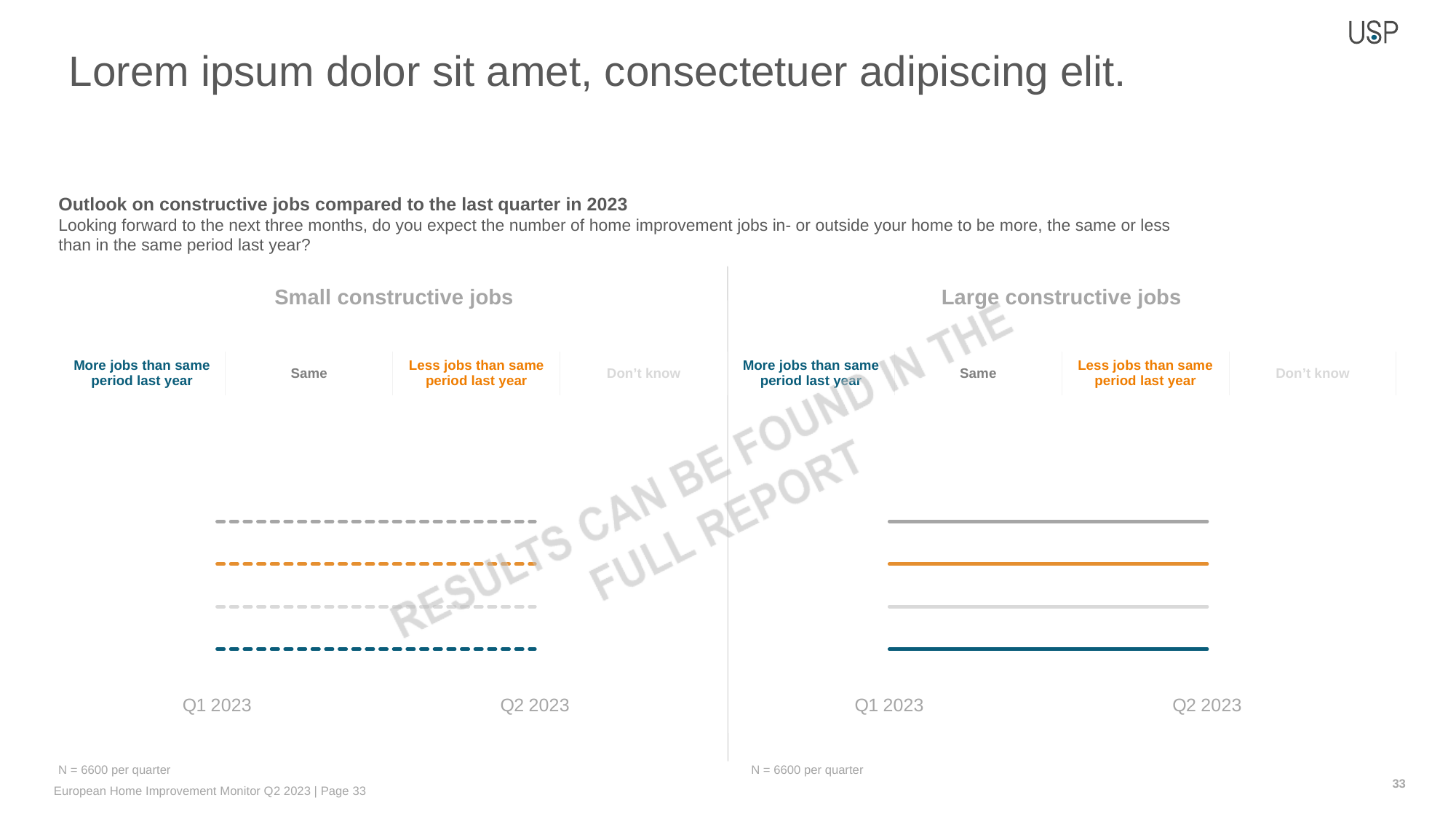
In the 'Small constructive jobs' chart, what colour is the 'Less jobs than same period last year' series? Orange In the 'Small constructive jobs' chart, does the 'Same' line rise or fall from Q1 2023 to Q2 2023? Neither, it stays flat In the 'Large constructive jobs' chart, how many series does the legend list? 4 In the 'Small constructive jobs' chart, how many series does the legend list? 4 What kind of chart is the 'Large constructive jobs' chart? Line chart In the 'Large constructive jobs' chart, does the 'More jobs than same period last year' line rise or fall from Q1 2023 to Q2 2023? Neither, it stays flat What kind of chart is the 'Small constructive jobs' chart? Line chart In the 'Small constructive jobs' chart, how many points are shown along the x axis? 2 In the 'Large constructive jobs' chart, how many quarters are shown on the x axis? 2 What is the title of the chart on the right side of the slide? Large constructive jobs